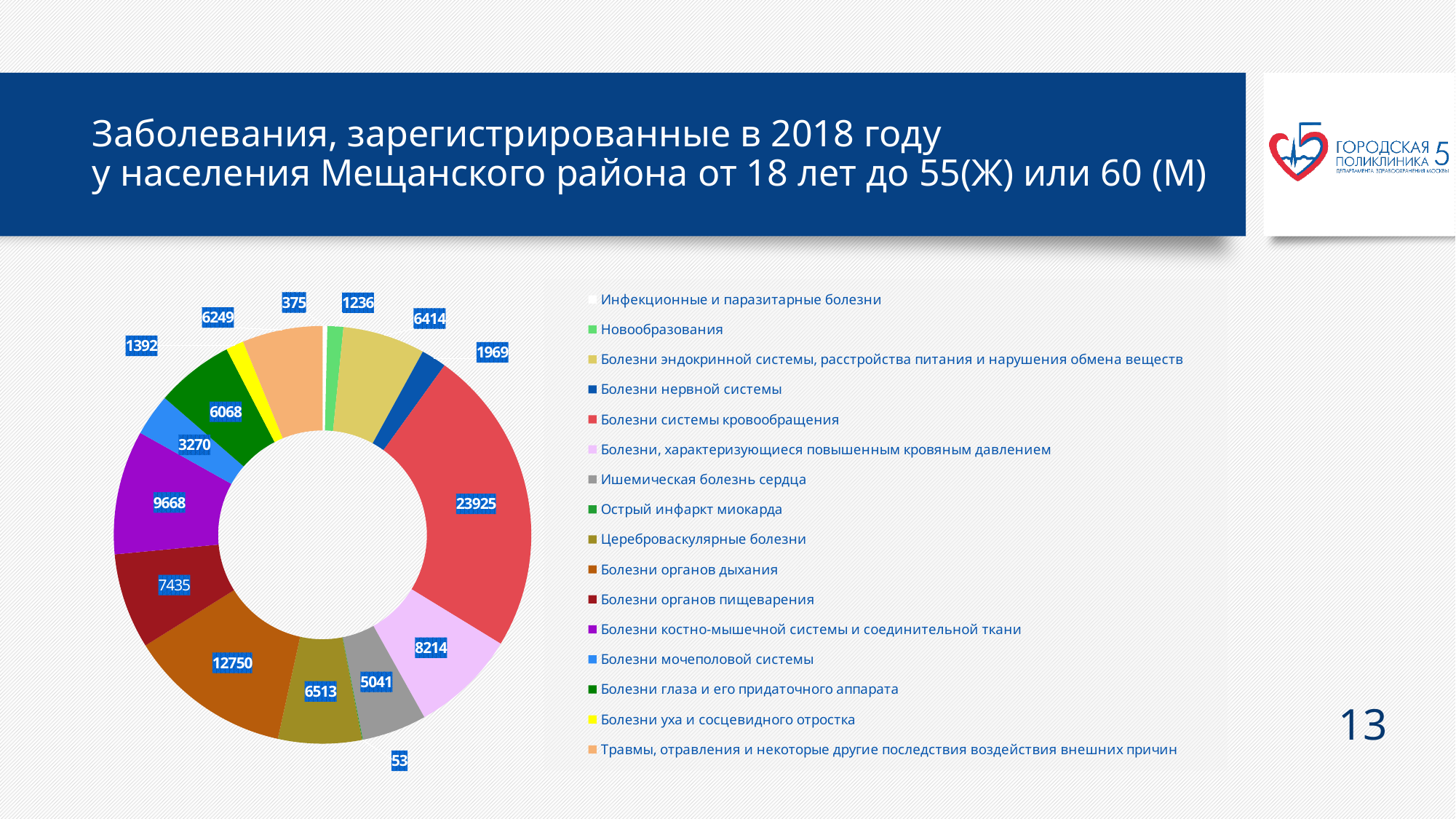
What is the difference between Болезни, характеризующиеся повышенным кровяным давлением and Ишемическая болезнь сердца? 3173 What type of chart is shown on the slide? Doughnut (pie) chart Which category has the highest value? Болезни системы кровообращения What is the value for Болезни системы кровообращения? 23925 Which is larger: Болезни органов пищеварения or Болезни эндокринной системы, расстройства питания и нарушения обмена веществ? Болезни органов пищеварения What is the difference between Болезни системы кровообращения and Болезни органов дыхания? 11175 What is the value for Болезни костно-мышечной системы и соединительной ткани? 9668 What is the value for Острый инфаркт миокарда? 53 What colour is the slice for Болезни мочеполовой системы? Blue Which category has the lowest value? Острый инфаркт миокарда What is the value for Болезни органов дыхания? 12750 How many disease categories does the legend list? 16